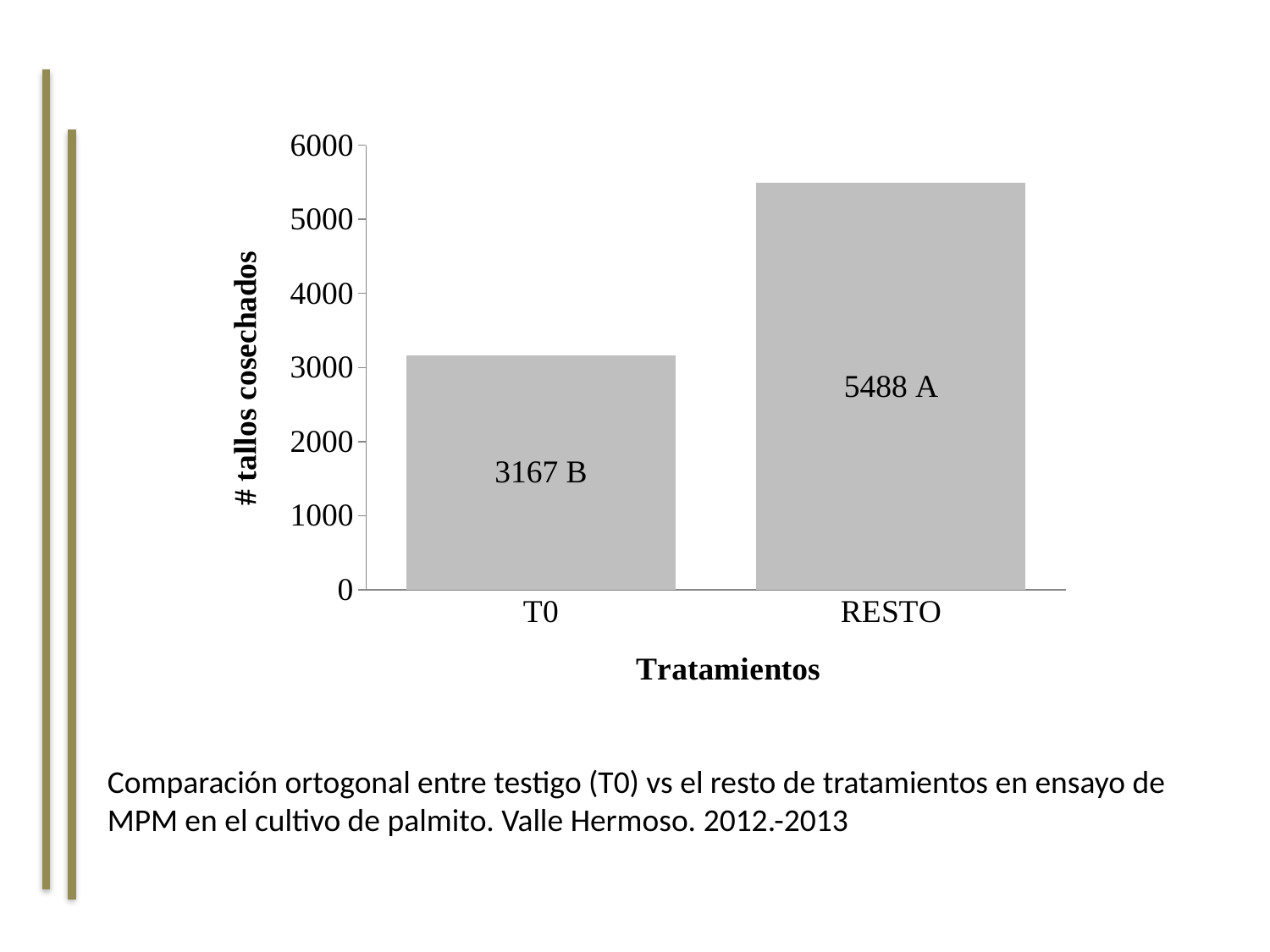
What is the label of the x axis? Tratamientos How many treatments (categories) are shown on the x axis? 2 What statistical grouping letter is shown next to the value for RESTO? A Which has more harvested stems, T0 or RESTO? RESTO What is the difference in harvested stems between RESTO and T0? 2321 Is the value for RESTO greater or less than 5000? greater Which treatment has the lowest number of harvested stems? T0 What kind of chart is shown on the slide? bar chart Which treatment has the highest number of harvested stems? RESTO Is the value for T0 greater or less than 4000? less What is the number of harvested stems (# tallos cosechados) for RESTO? 5488 What is the number of harvested stems (# tallos cosechados) for T0? 3167